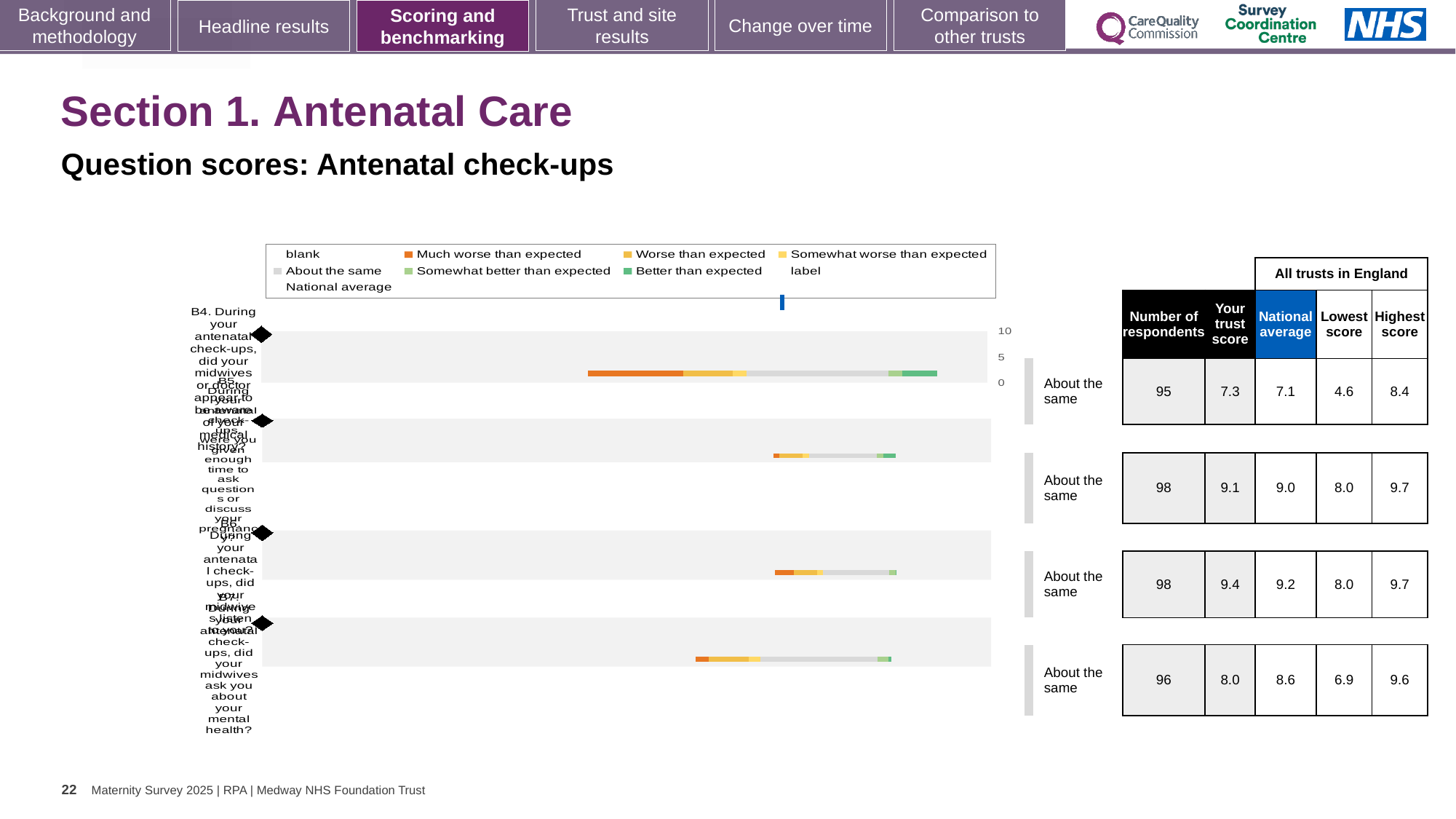
How many question bars are plotted in the chart? 4 What heading appears above the National average, Lowest score and Highest score columns in the table? All trusts in England Which row of the table has the lowest Number of respondents? the first row (95) In the table, what is the National average for the last row (question B7)? 8.6 What colour represents 'Much worse than expected' in the chart legend? orange Which row of the table has the highest 'Your trust score'? the third row (9.4) In the last row of the table, which is larger: Your trust score or the National average? National average In the table, what is the Number of respondents for the second row? 98 In the table, what is the 'Your trust score' for the first row (question B4)? 7.3 What kind of chart is shown on the slide? bar chart In the first row of the table, what is the difference between the Highest score and the Lowest score? 3.8 In the third row of the table, which is larger: Your trust score or the National average? Your trust score